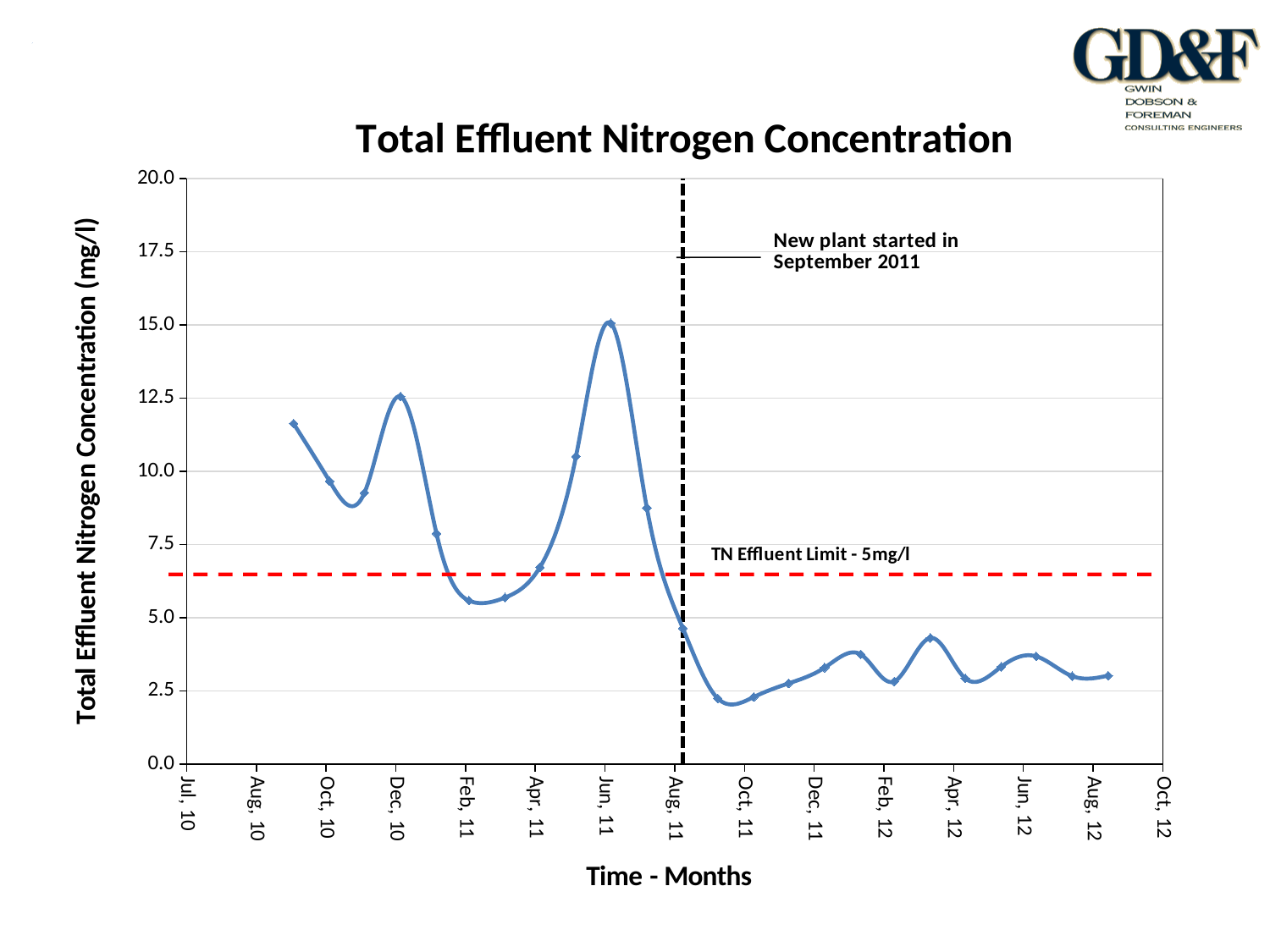
Which is larger, the value for Dec, 10 or the value for Feb, 11? Dec, 10 Is the value for Feb, 11 greater or less than 7.5? less Is the value for Dec, 10 greater or less than 10.0? greater What label does the red dashed horizontal line carry? TN Effluent Limit - 5mg/l Is the value for Oct, 11 greater or less than 5.0? less Which month has the highest total effluent nitrogen concentration? Jun, 11 What kind of chart is shown on the slide? line chart Are the values after the new plant started in September 2011 generally higher or lower than the values before it? lower What is the title of the chart? Total Effluent Nitrogen Concentration